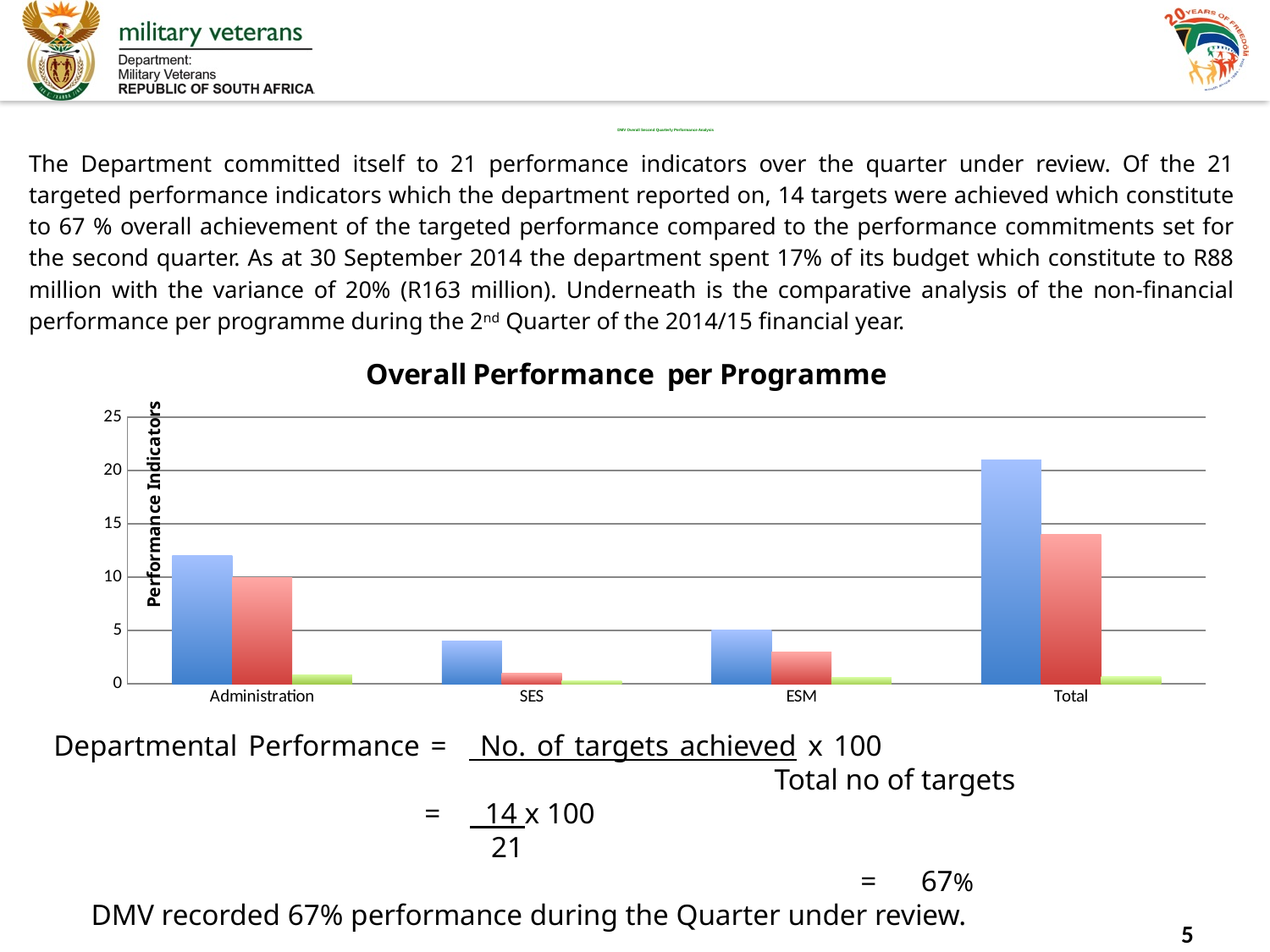
Which category has the shortest blue bar in the chart? SES Is the blue bar for Total greater or less than 20? greater Is the red bar for Total greater or less than 15? less Is the blue bar for SES greater or less than 5? less What type of chart is shown on the slide? bar chart Which has a taller blue bar, Administration or ESM? Administration What is the label of the vertical axis of the chart? Performance Indicators How many categories are shown on the x axis of the chart? 4 Which category has the tallest bar in the chart? Total What is the title of the chart? Overall Performance per Programme Which has a taller red bar, SES or ESM? ESM